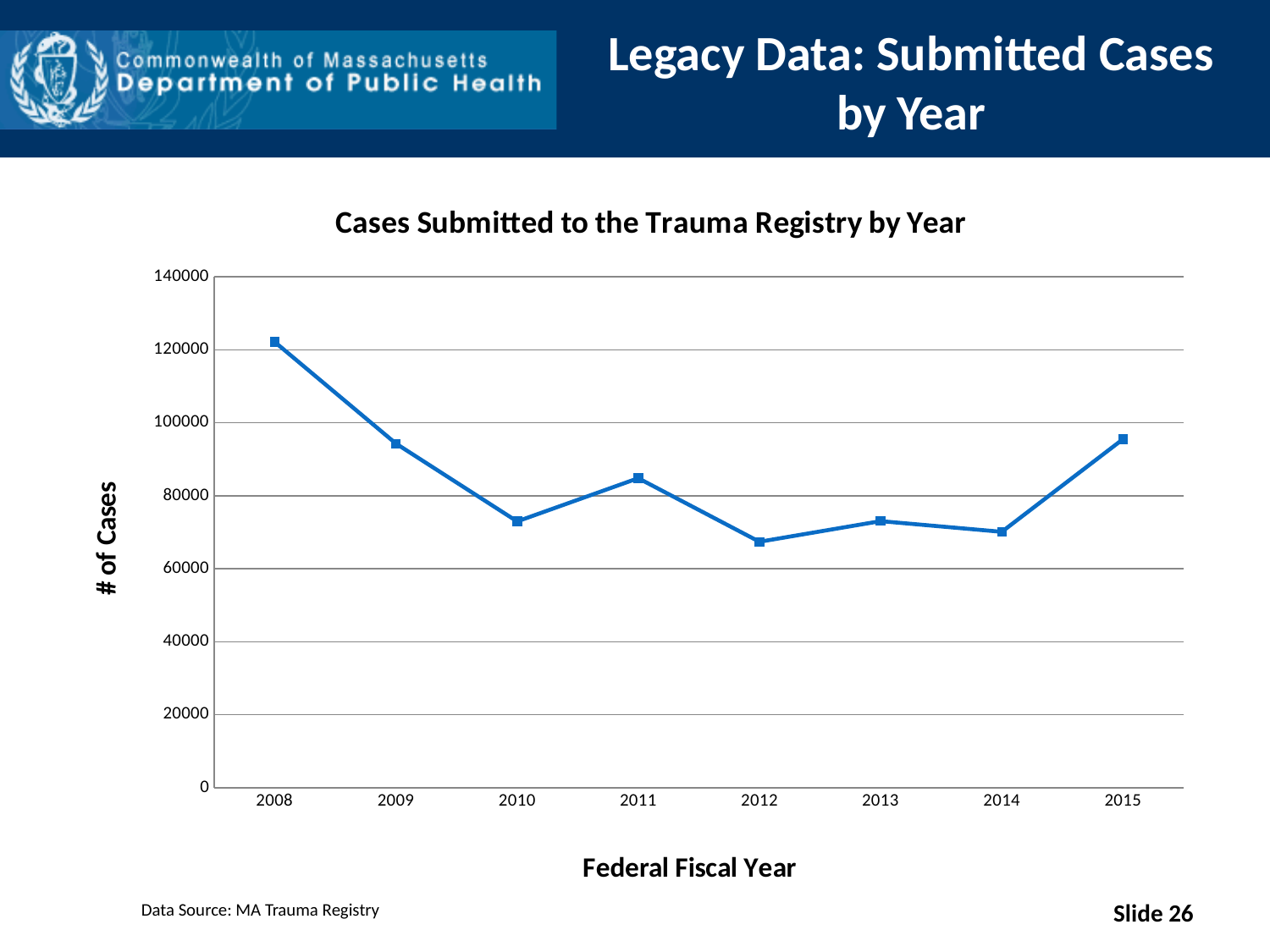
Is the value for 2008 greater or less than 100000? greater Which year has more submitted cases, 2008 or 2015? 2008 Is the value for 2011 greater or less than 80000? greater Is the value for 2012 greater or less than 80000? less What kind of chart is shown on the slide? line chart How many years are plotted on the x axis of the chart? 8 Which year has more submitted cases, 2010 or 2011? 2011 Which federal fiscal year has the highest number of cases submitted? 2008 Do the values rise or fall from 2008 to 2010? fall What is the label of the y axis of the chart? # of Cases